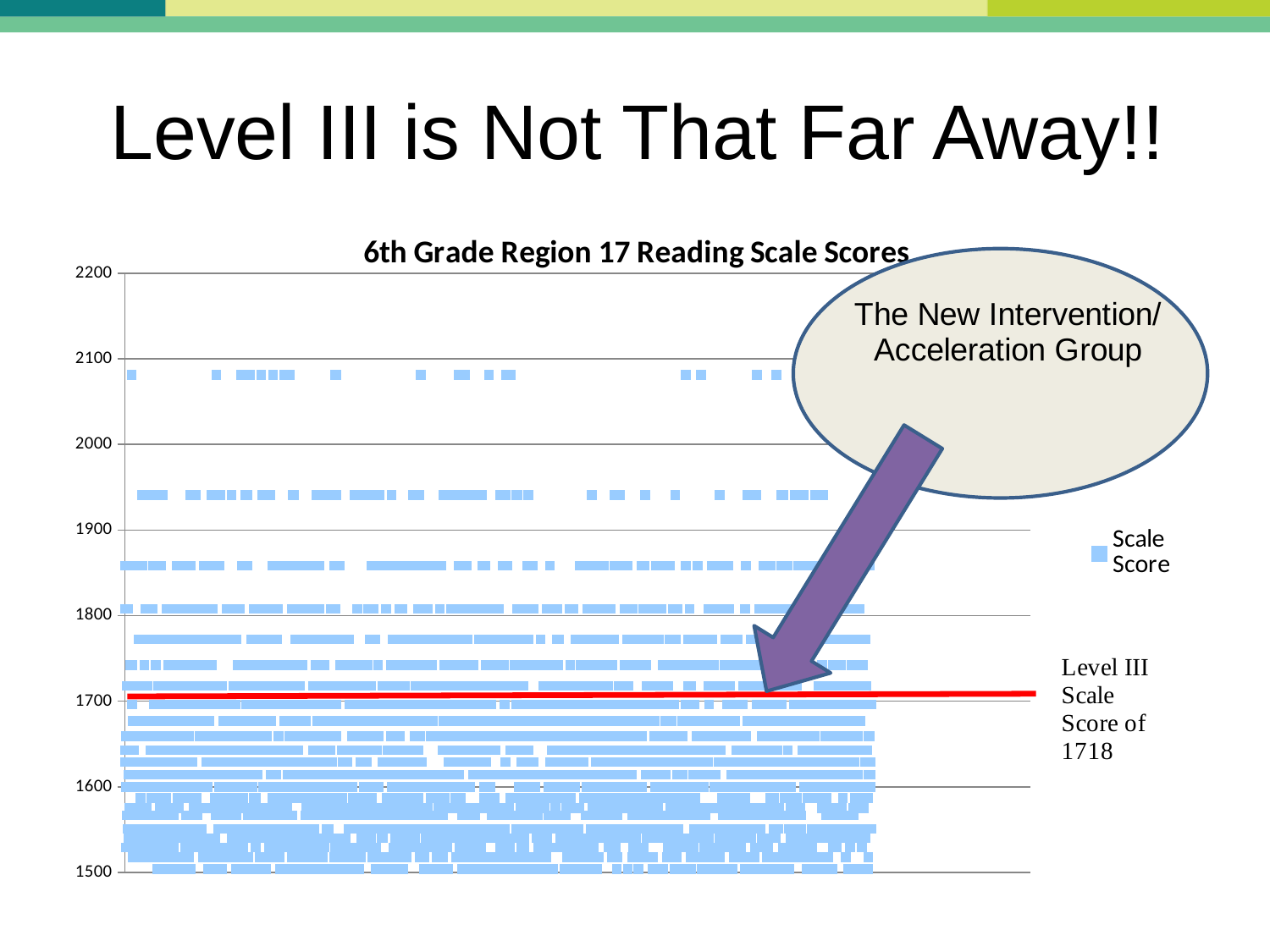
How many series does the chart legend list? 1 Is the lowest plotted scale score on the chart greater or less than 1600? less What scale score does the red horizontal line on the chart represent? 1718 Is the highest plotted scale score on the chart greater or less than 2100? less What is the title of the chart? 6th Grade Region 17 Reading Scale Scores What is the name of the series shown in the chart legend? Scale Score What kind of chart is shown on the slide? scatter chart Is the Level III scale score marked by the red line greater or less than 1700? greater